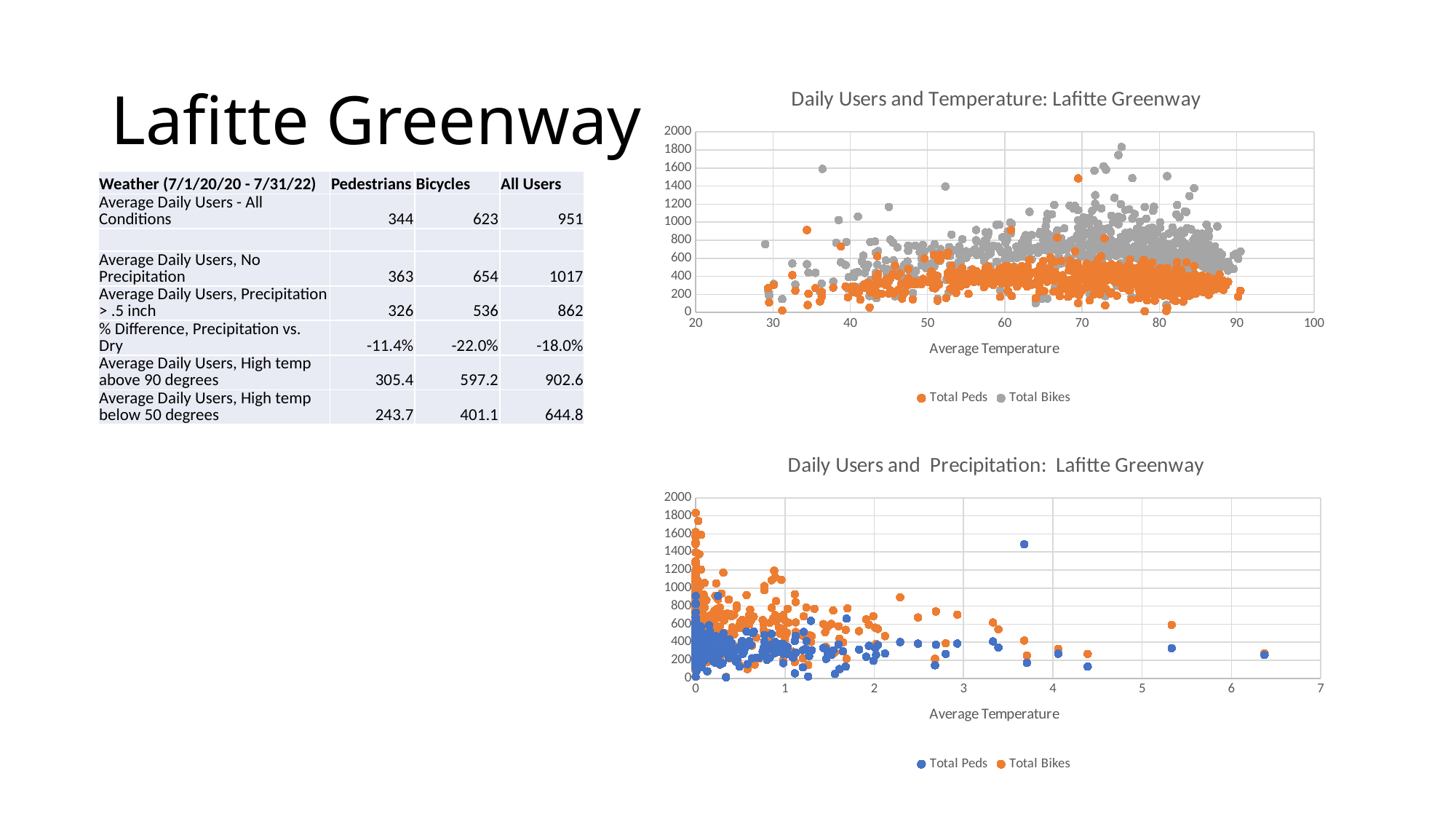
In the top chart (Daily Users and Temperature), is the highest Total Bikes point greater or less than 1600? greater What kind of chart is the top chart titled "Daily Users and Temperature: Lafitte Greenway"? Scatter chart In the bottom chart (Daily Users and Precipitation), which series is shown in blue? Total Peds In the bottom chart (Daily Users and Precipitation), do the Total Bikes values generally rise or fall as the x-axis value increases? fall In the top chart (Daily Users and Temperature), which series is shown in gray? Total Bikes How many series does the legend of the top chart (Daily Users and Temperature) list? 2 How many series does the legend of the bottom chart (Daily Users and Precipitation) list? 2 What kind of chart is the bottom chart titled "Daily Users and Precipitation: Lafitte Greenway"? Scatter chart In the top chart (Daily Users and Temperature), which series generally has the higher values, Total Peds or Total Bikes? Total Bikes In the bottom chart (Daily Users and Precipitation), is the highest Total Peds point greater or less than 1200? greater In the top chart (Daily Users and Temperature), is the highest Total Peds point greater or less than 1200? greater In the top chart (Daily Users and Temperature), do the Total Bikes values generally rise or fall as average temperature increases from 40 to 80? rise